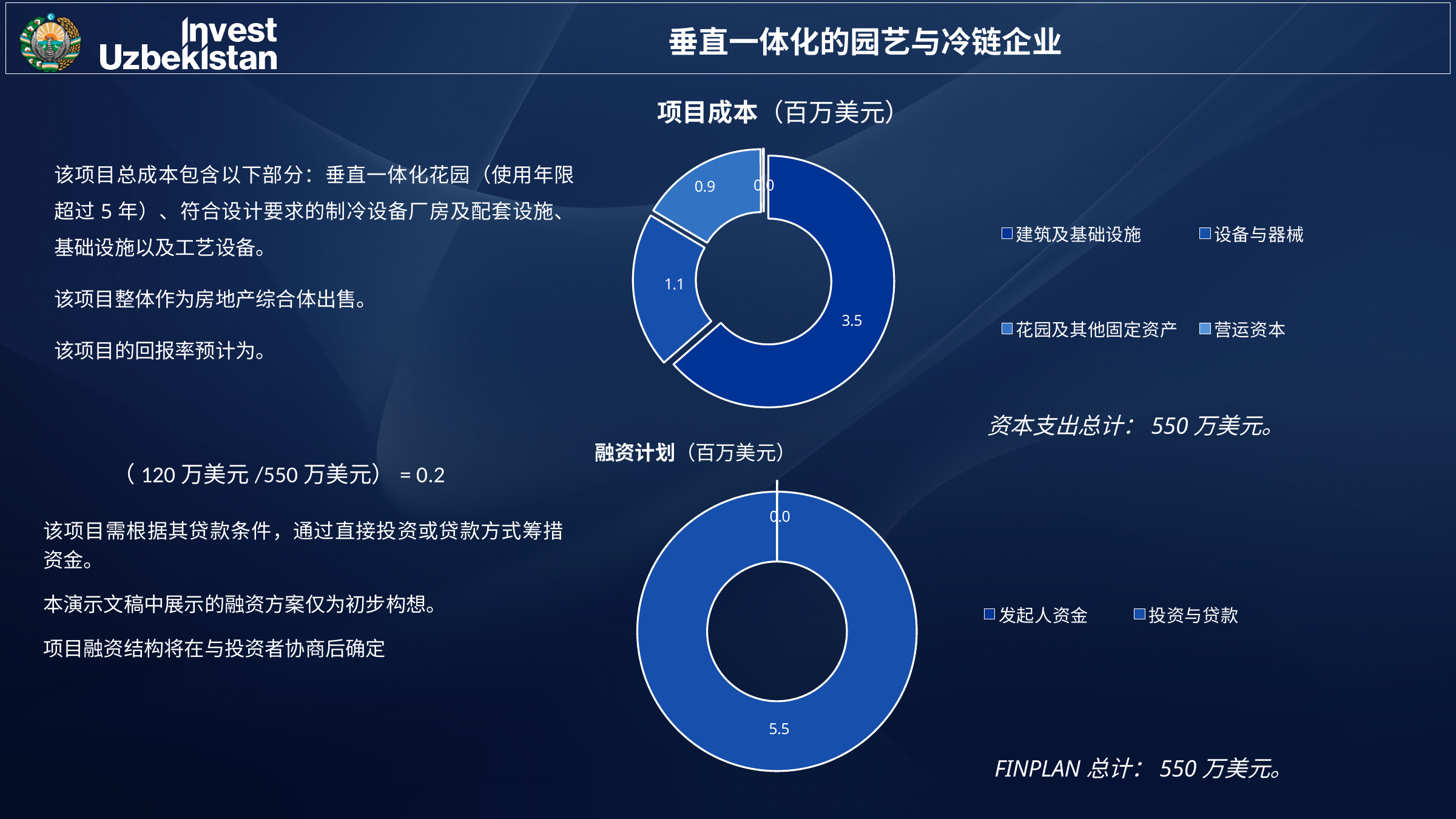
In the 项目成本（百万美元） chart, which is larger: 设备与器械 or 花园及其他固定资产? 设备与器械 In the 项目成本（百万美元） chart, what is the difference between 建筑及基础设施 and 设备与器械? 2.4 What type of chart is the 项目成本（百万美元） chart? Doughnut (pie) chart In the 融资计划（百万美元） chart, what is the value for 发起人资金? 0.0 In the 融资计划（百万美元） chart, what is the value for 投资与贷款? 5.5 In the 项目成本（百万美元） chart, what is the value for 设备与器械? 1.1 In the 项目成本（百万美元） chart, what is the value for 花园及其他固定资产? 0.9 In the 项目成本（百万美元） chart, which category has the smallest value? 营运资本 In the 项目成本（百万美元） chart, which category has the largest value? 建筑及基础设施 How many categories does the legend of the 融资计划（百万美元） chart list? 2 How many categories does the legend of the 项目成本（百万美元） chart list? 4 In the 项目成本（百万美元） chart, what is the value for 建筑及基础设施? 3.5